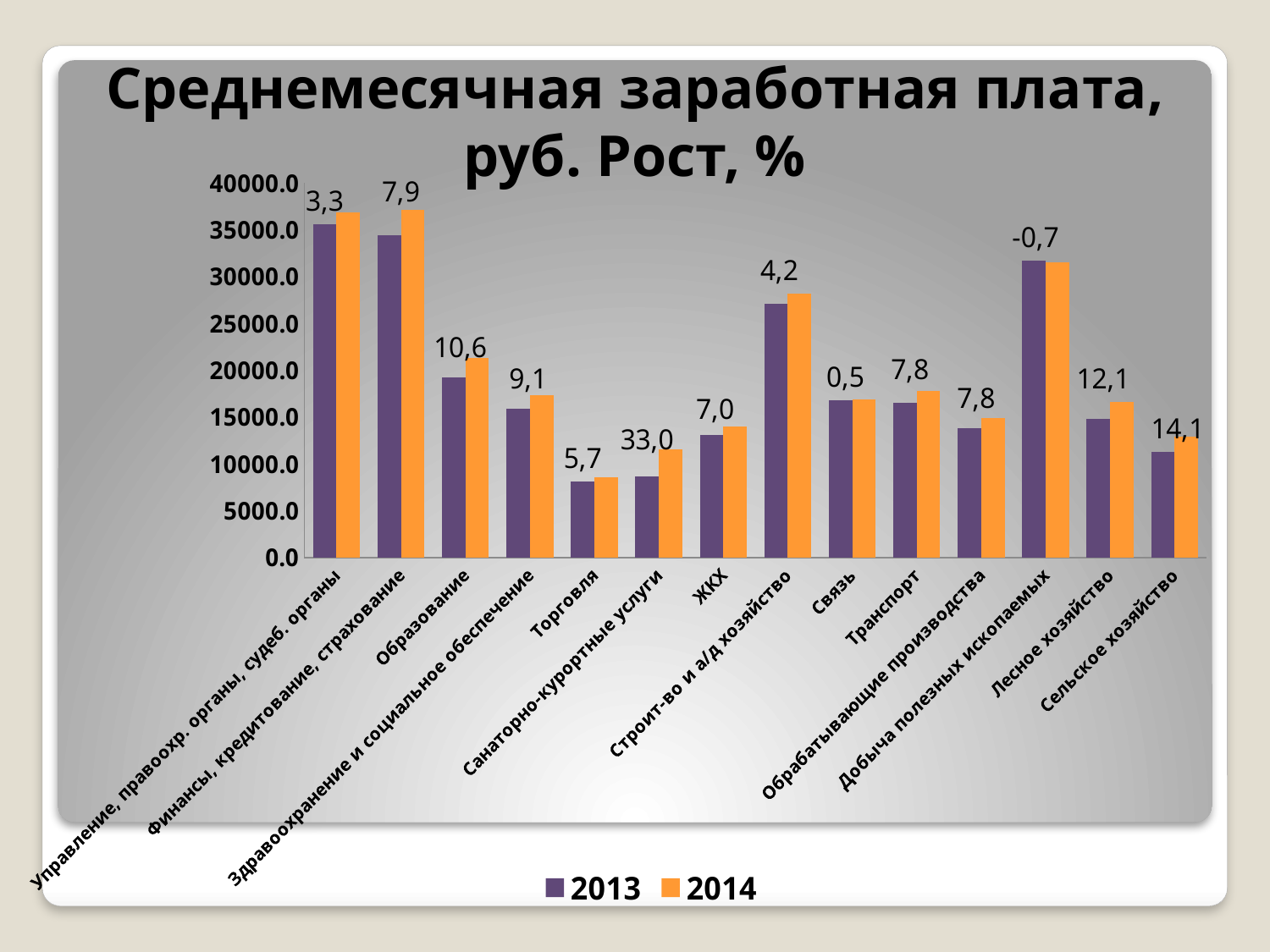
Is the 2013 value for Торговля greater or less than 10000.0? less Which is larger, the 2014 value for Образование or the 2014 value for Здравоохранение и социальное обеспечение? Образование What growth percentage is printed above the bars for Добыча полезных ископаемых? -0,7 What growth percentage is printed above the bars for Санаторно-курортные услуги? 33,0 Which category has the lowest printed growth percentage? Добыча полезных ископаемых What growth percentage is printed above the bars for Образование? 10,6 How many categories are shown on the x axis? 14 How many series does the legend list? 2 Is the 2014 value for Образование greater or less than 20000.0? greater What type of chart is shown on the slide? bar chart Which category has the highest printed growth percentage? Санаторно-курортные услуги What is the difference between the printed growth percentages for Сельское хозяйство and Лесное хозяйство? 2,0